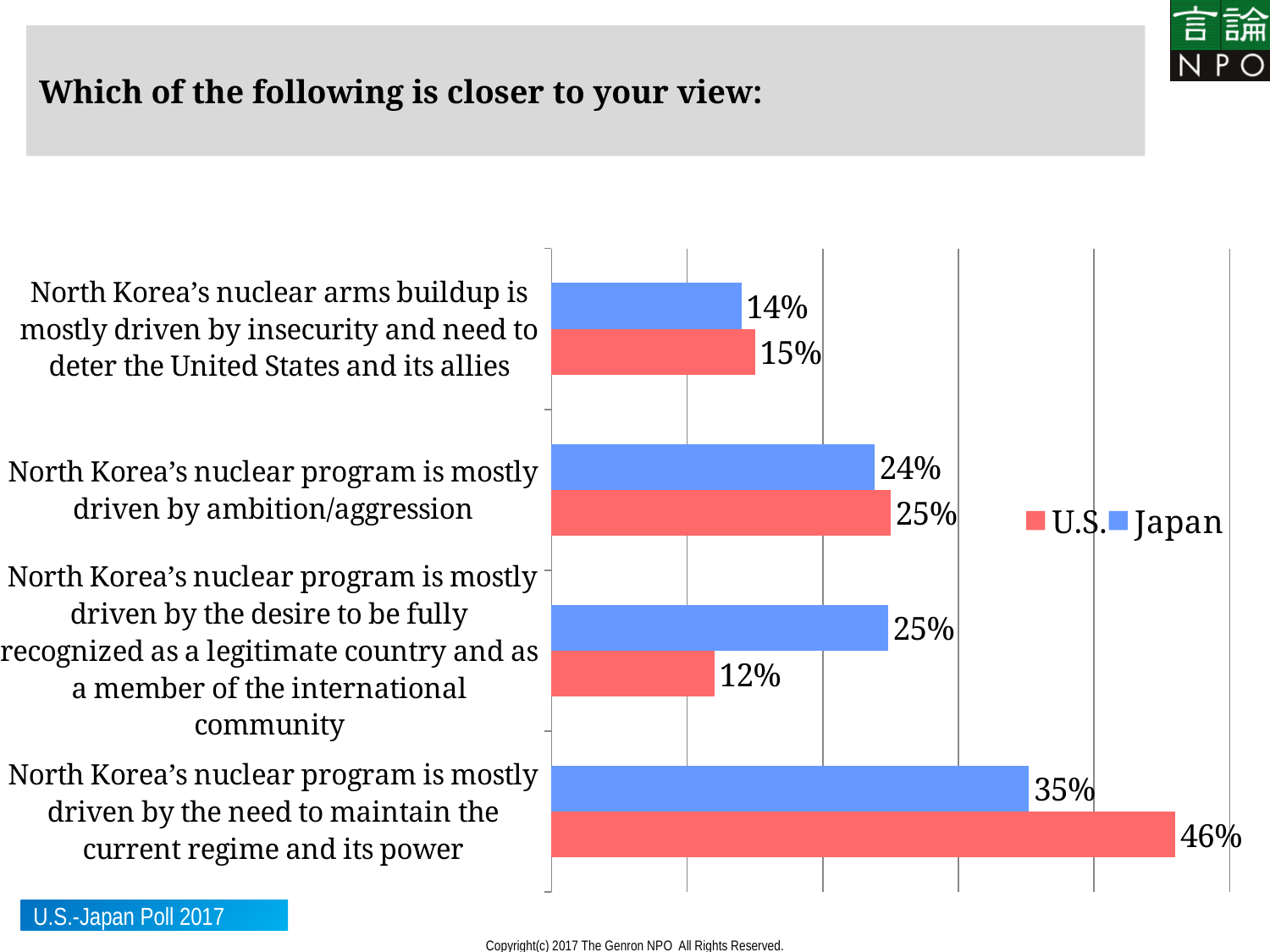
What percentage of Japanese respondents said North Korea's nuclear arms buildup is mostly driven by insecurity and the need to deter the United States and its allies? 14% What percentage of Japanese respondents said North Korea's nuclear program is mostly driven by the desire to be fully recognized as a legitimate country and a member of the international community? 25% What is the difference between the U.S. and Japan percentages for the view that North Korea's nuclear program is mostly driven by the need to maintain the current regime and its power? 11 percentage points Which colour represents the U.S. series in the chart? Red Which view received the lowest share of Japanese respondents? North Korea's nuclear arms buildup is mostly driven by insecurity and need to deter the United States and its allies What percentage of U.S. respondents said North Korea's nuclear program is mostly driven by ambition/aggression? 25% Which view received the highest share of U.S. respondents? North Korea's nuclear program is mostly driven by the need to maintain the current regime and its power What percentage of U.S. respondents said North Korea's nuclear program is mostly driven by the need to maintain the current regime and its power? 46% What type of chart is shown on the slide? Bar chart How many views (categories) are shown in the chart? 4 How many series does the legend list? 2 For the view that North Korea's nuclear program is driven by the desire to be recognized as a legitimate country, which country had the larger share of respondents, the U.S. or Japan? Japan